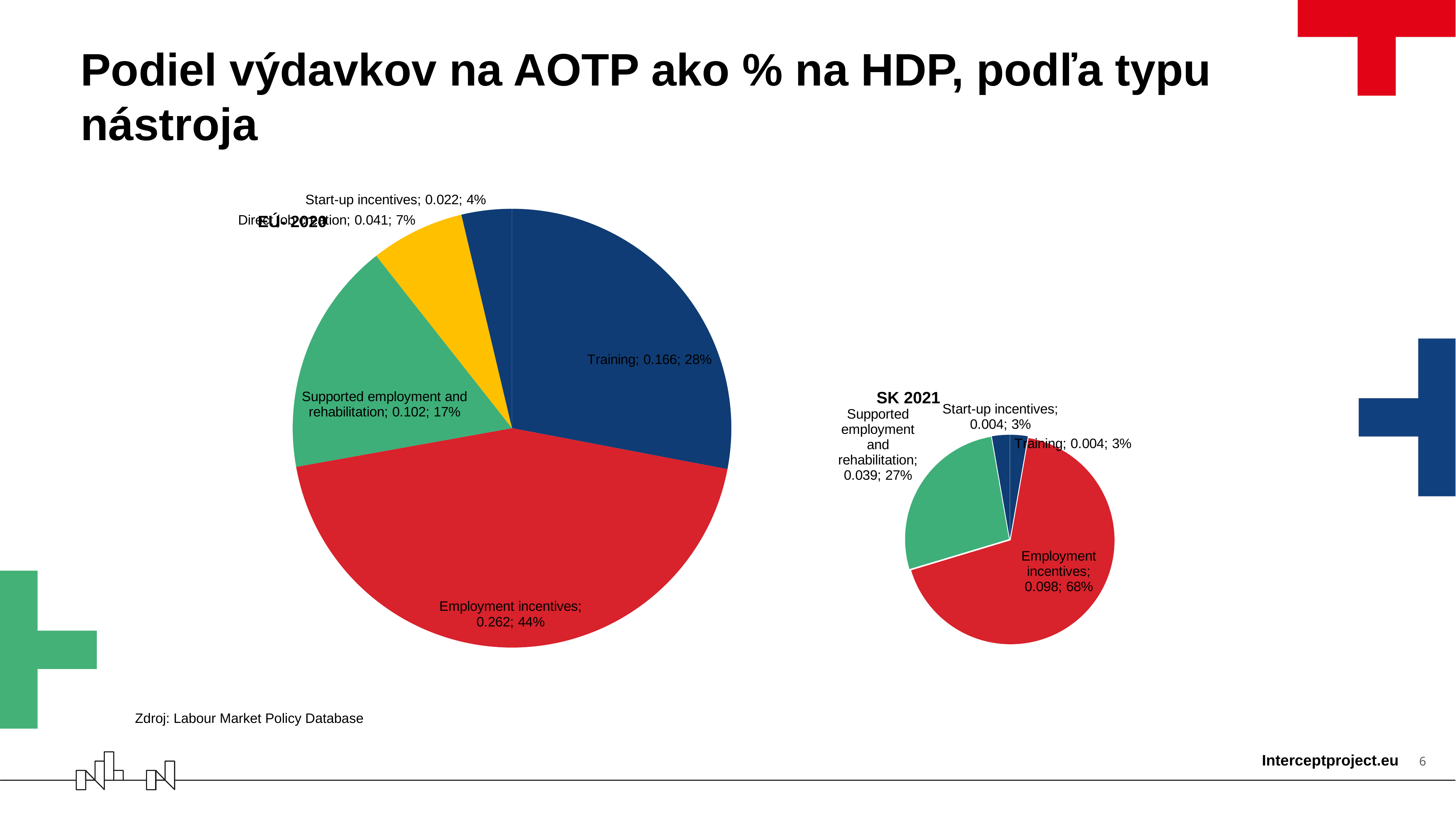
In the EÚ 2020 pie chart, what is the difference between the values for Employment incentives and Training? 0.096 In the EÚ 2020 pie chart, what value is shown for Employment incentives? 0.262 In the EÚ 2020 pie chart, what value is shown for Supported employment and rehabilitation? 0.102 In the SK 2021 pie chart, what value is shown for Supported employment and rehabilitation? 0.039 What type of chart is used for the EÚ 2020 data on the left? Pie chart How many slices does the SK 2021 pie chart have? 4 In the EÚ 2020 pie chart, which category has the smallest slice? Start-up incentives In the SK 2021 pie chart, what share of the pie does Employment incentives represent? 68% In the EÚ 2020 pie chart, what share of the pie does Training represent? 28% How many slices does the EÚ 2020 pie chart have? 5 In the SK 2021 pie chart, which is larger: Supported employment and rehabilitation or Training? Supported employment and rehabilitation In the EÚ 2020 pie chart, which category has the largest slice? Employment incentives